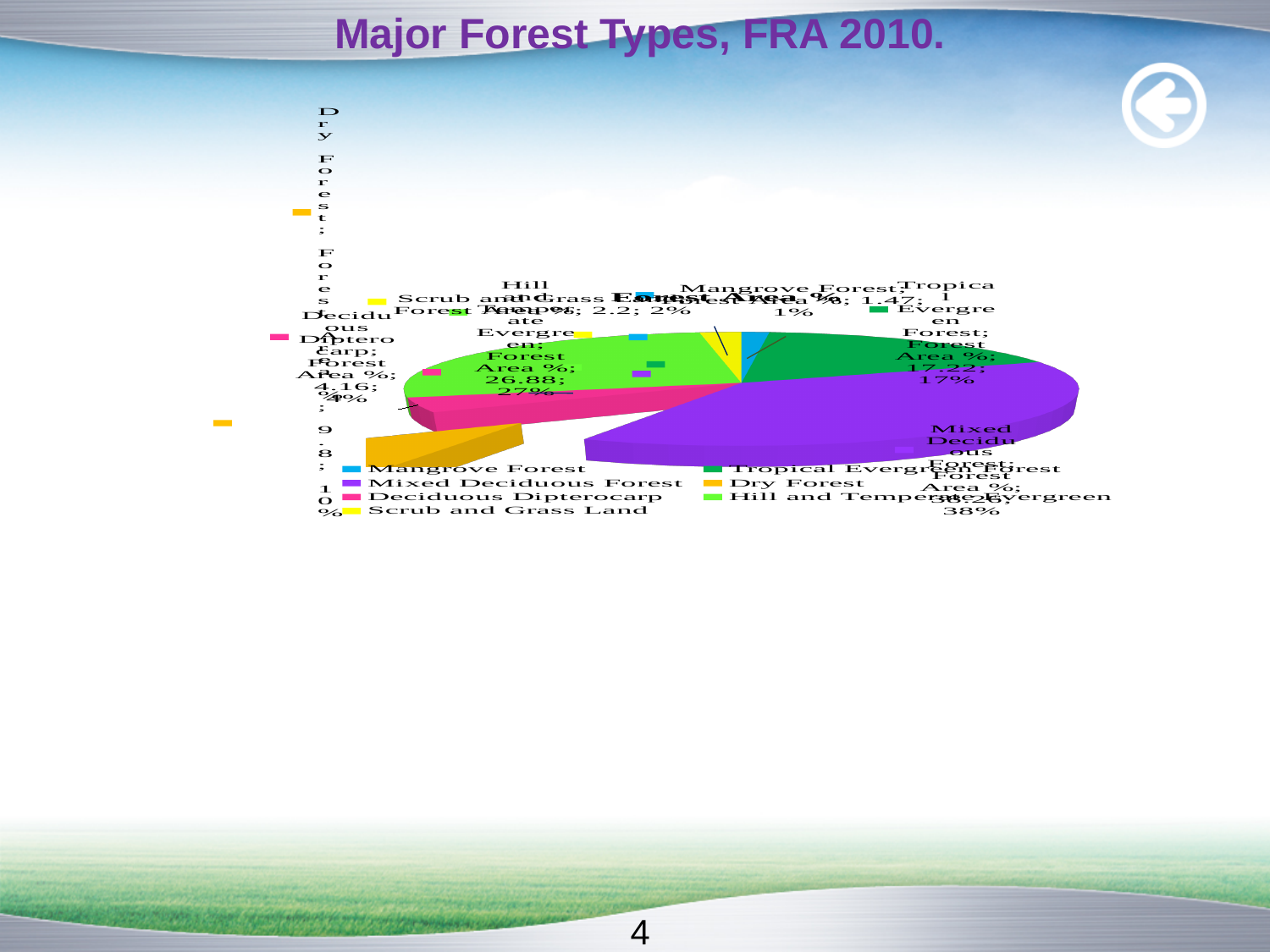
What is the forest area % value for Mangrove Forest? 1.47 What is the forest area % value for Tropical Evergreen Forest? 17.22 What kind of chart is shown on the slide? Pie chart What is the forest area % value for Mixed Deciduous Forest? 38.26 Which forest type has the largest share of the pie? Mixed Deciduous Forest How many forest types (categories) does the pie chart show? 7 What is the difference between the values for Mixed Deciduous Forest and Hill and Temperate Evergreen? 11.38 Which is larger, the value for Deciduous Dipterocarp or the value for Scrub and Grass Land? Deciduous Dipterocarp Which forest type has the smallest share of the pie? Mangrove Forest What is the forest area % value for Dry Forest? 9.8 What percentage share of the pie does Hill and Temperate Evergreen have? 27% What is the forest area % value for Hill and Temperate Evergreen? 26.88